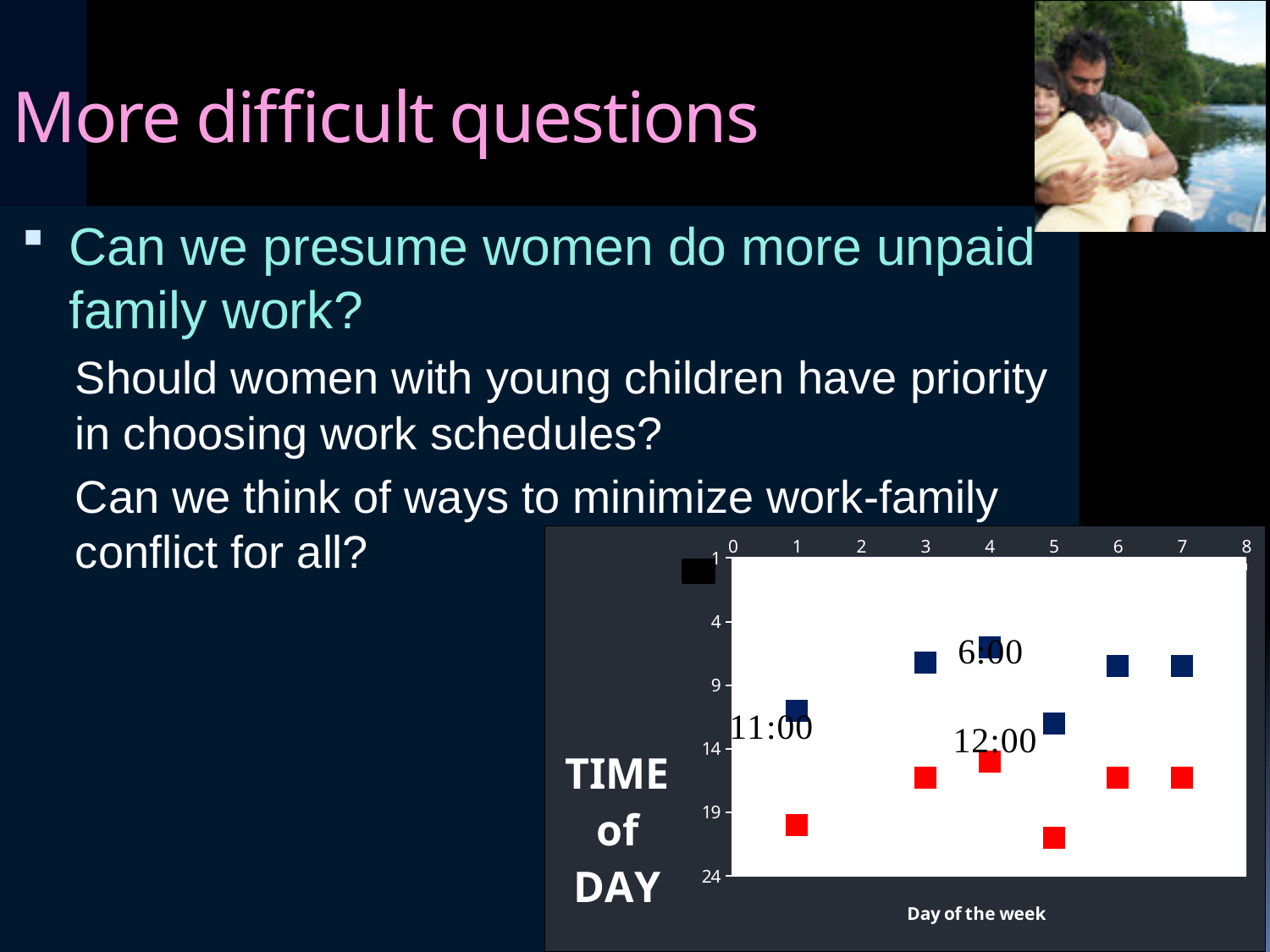
Is the time-of-day value of the dark blue point at day 3 greater or less than 9? less What is the title of the horizontal axis of the chart? Day of the week Is the time-of-day value of the dark blue point at day 5 greater or less than 9? greater How many red points are plotted on the chart? 6 How many different days of the week have points plotted on the chart? 6 At day 4, which series has the larger time-of-day value, the red point or the dark blue point? the red point How many dark blue points are plotted on the chart? 6 Is the time-of-day value of the red point at day 5 greater or less than 19? greater What kind of chart is shown on the slide? scatter chart What is the highest value shown on the vertical axis of the chart? 24 What label is written beside the vertical axis of the chart? TIME of DAY